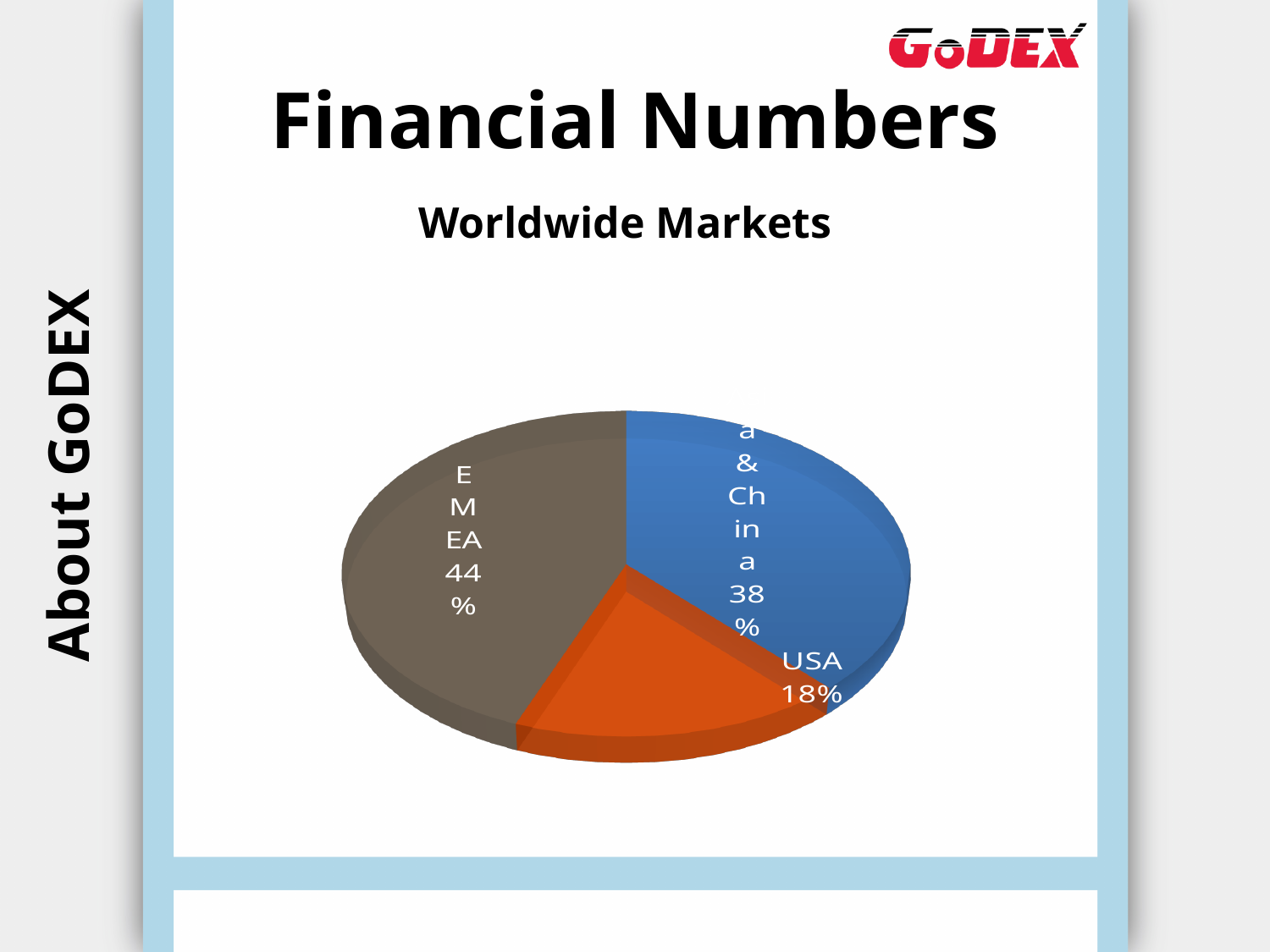
What colour is the EMEA slice of the pie chart? Grey-brown Which is larger, the share for EMEA or the share for USA? EMEA What percentage is shown for USA in the pie chart? 18% What is the title of the pie chart? Worldwide Markets What type of chart is shown on the slide? Pie chart What is the difference in percentage points between EMEA and USA? 26 percentage points Is the share for EMEA greater or less than 40%? greater What percentage is shown for the slice whose label ends in '& China'? 38% How many slices does the pie chart have? 3 Which labelled region has the largest share of the pie? EMEA Which labelled region has the smallest share of the pie? USA What share of the pie does EMEA hold? 44%